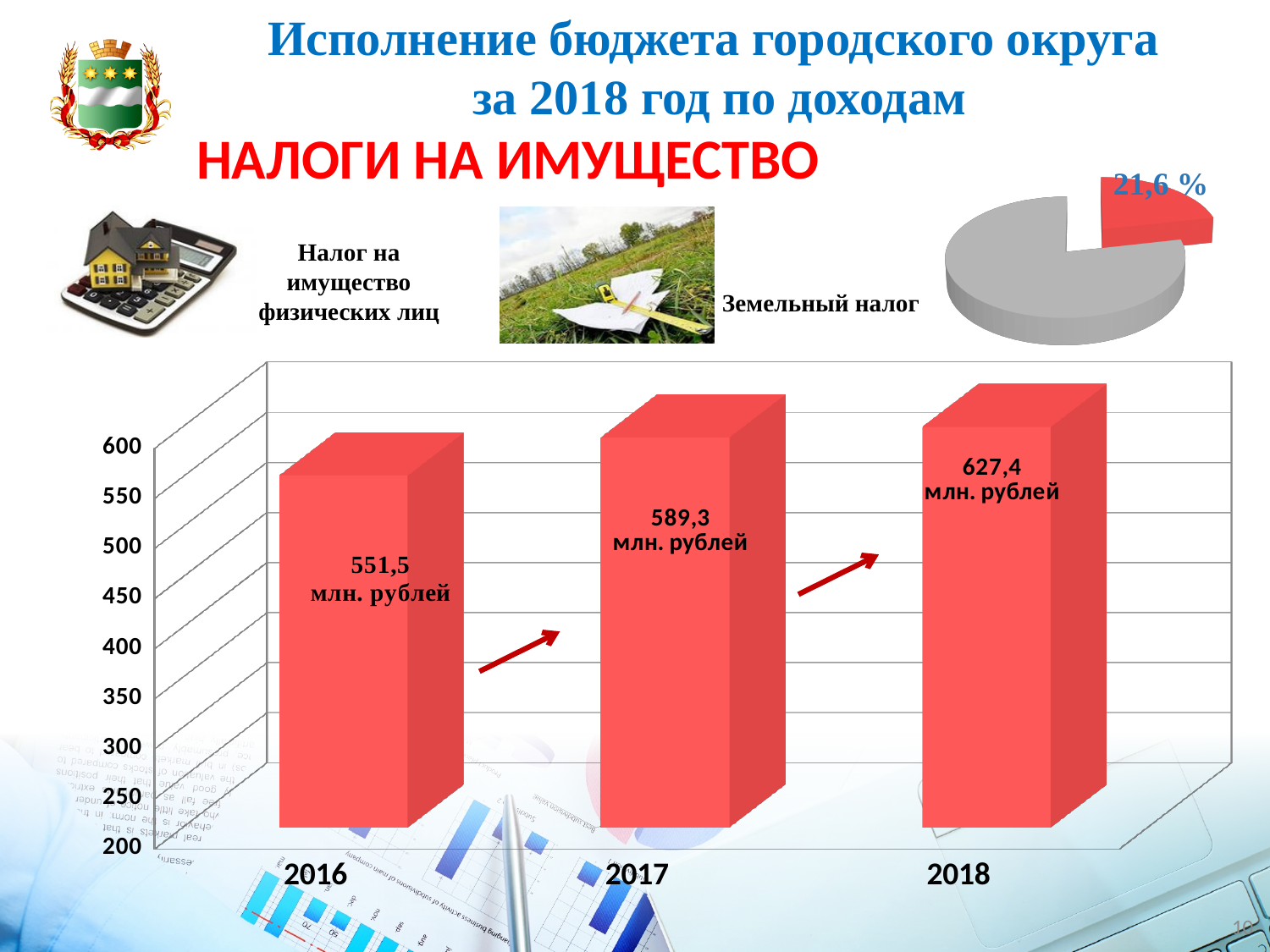
In the bar chart at the bottom of the slide, what is the difference between the 2017 and 2016 values? 37,8 млн. рублей In the bar chart at the bottom of the slide, what is the value for 2017? 589,3 млн. рублей In the bar chart at the bottom of the slide, which year has the lowest value? 2016 What kind of chart is shown at the bottom of the slide? Bar chart In the bar chart at the bottom of the slide, do the values rise or fall from 2016 to 2018? Rise In the bar chart at the bottom of the slide, which year has the highest value? 2018 In the bar chart at the bottom of the slide, how many years are shown? 3 In the bar chart at the bottom of the slide, what is the value for 2018? 627,4 млн. рублей In the bar chart at the bottom of the slide, what is the value for 2016? 551,5 млн. рублей In the pie chart at the top right of the slide, what share is shown for the red slice? 21,6 % In the bar chart at the bottom of the slide, what is the difference between the 2018 and 2017 values? 38,1 млн. рублей In the bar chart at the bottom of the slide, which is larger: the value for 2016 or the value for 2017? 2017